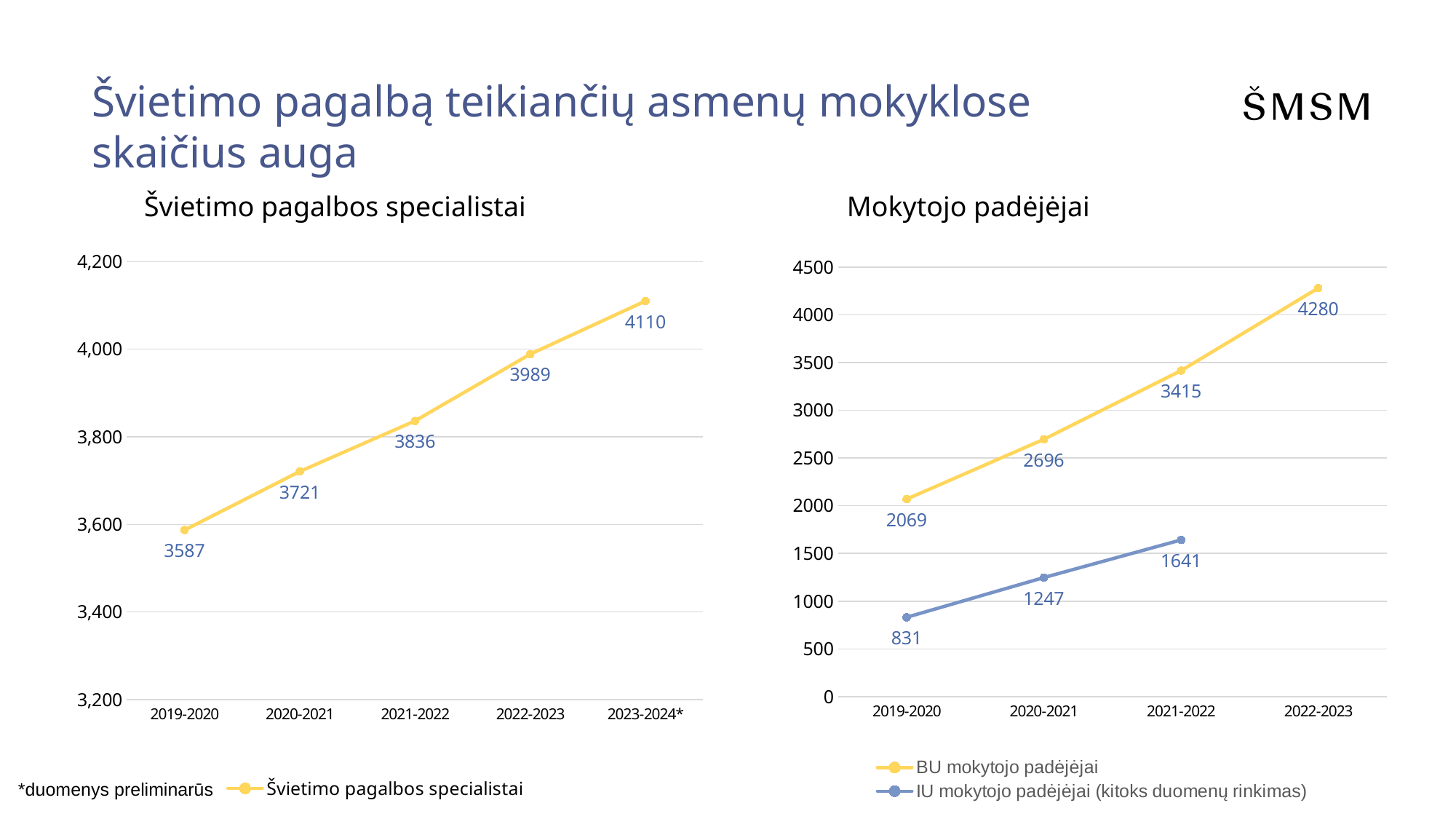
In the 'Mokytojo padėjėjai' chart, what is the value for BU mokytojo padėjėjai in 2020-2021? 2696 In the 'Mokytojo padėjėjai' chart, which year has the highest value for BU mokytojo padėjėjai? 2022-2023 What type of chart is the 'Mokytojo padėjėjai' chart? line chart In the 'Švietimo pagalbos specialistai' chart, do the values rise or fall from 2019-2020 to 2023-2024*? rise In the 'Švietimo pagalbos specialistai' chart, how many data points are plotted? 5 In the 'Švietimo pagalbos specialistai' chart, what is the difference between the 2022-2023 and 2019-2020 values? 402 In the 'Mokytojo padėjėjai' chart, what is the difference between BU and IU mokytojo padėjėjai in 2019-2020? 1238 In the 'Švietimo pagalbos specialistai' chart, what is the value for 2023-2024*? 4110 In the 'Mokytojo padėjėjai' chart, how many series does the legend list? 2 In the 'Švietimo pagalbos specialistai' chart, which year has the lowest value? 2019-2020 In the 'Švietimo pagalbos specialistai' chart, what is the value for 2021-2022? 3836 In the 'Mokytojo padėjėjai' chart, what is the value for IU mokytojo padėjėjai in 2021-2022? 1641